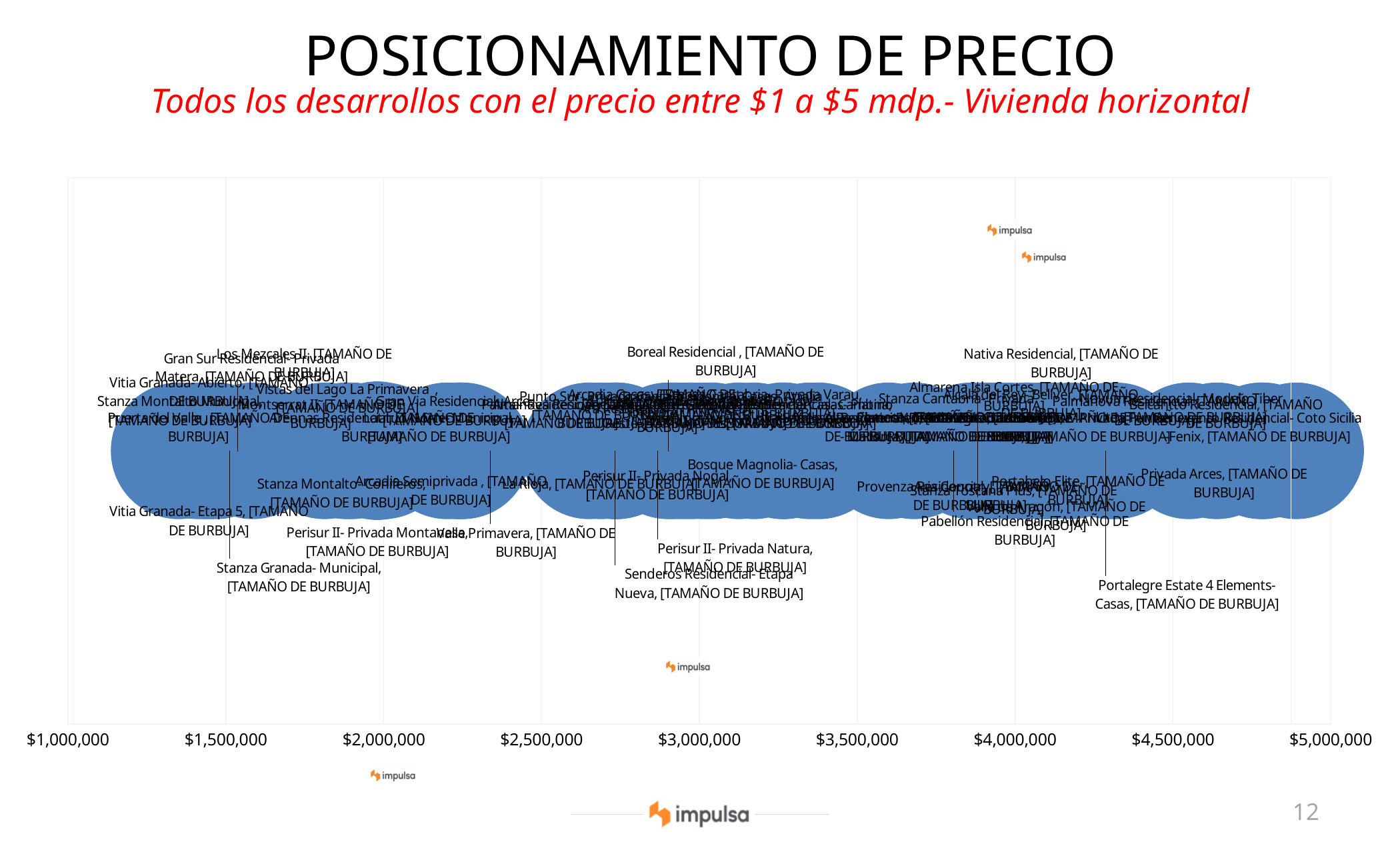
What is the lowest value shown on the x axis of the chart? $1,000,000 What is the title of the slide containing the chart? POSICIONAMIENTO DE PRECIO Is the price for Senderos Residencial- Etapa Nueva greater or less than $3,000,000? less Is the price for Portalegre Estate 4 Elements- Casas greater or less than $4,000,000? greater Is the price for Valle Primavera greater or less than $2,500,000? less Which has the higher price, Privada Arces or Vitia Granada- Etapa 5? Privada Arces What kind of chart is shown on the slide? bubble chart Which has the higher price, Portalegre Estate 4 Elements- Casas or Senderos Residencial- Etapa Nueva? Portalegre Estate 4 Elements- Casas